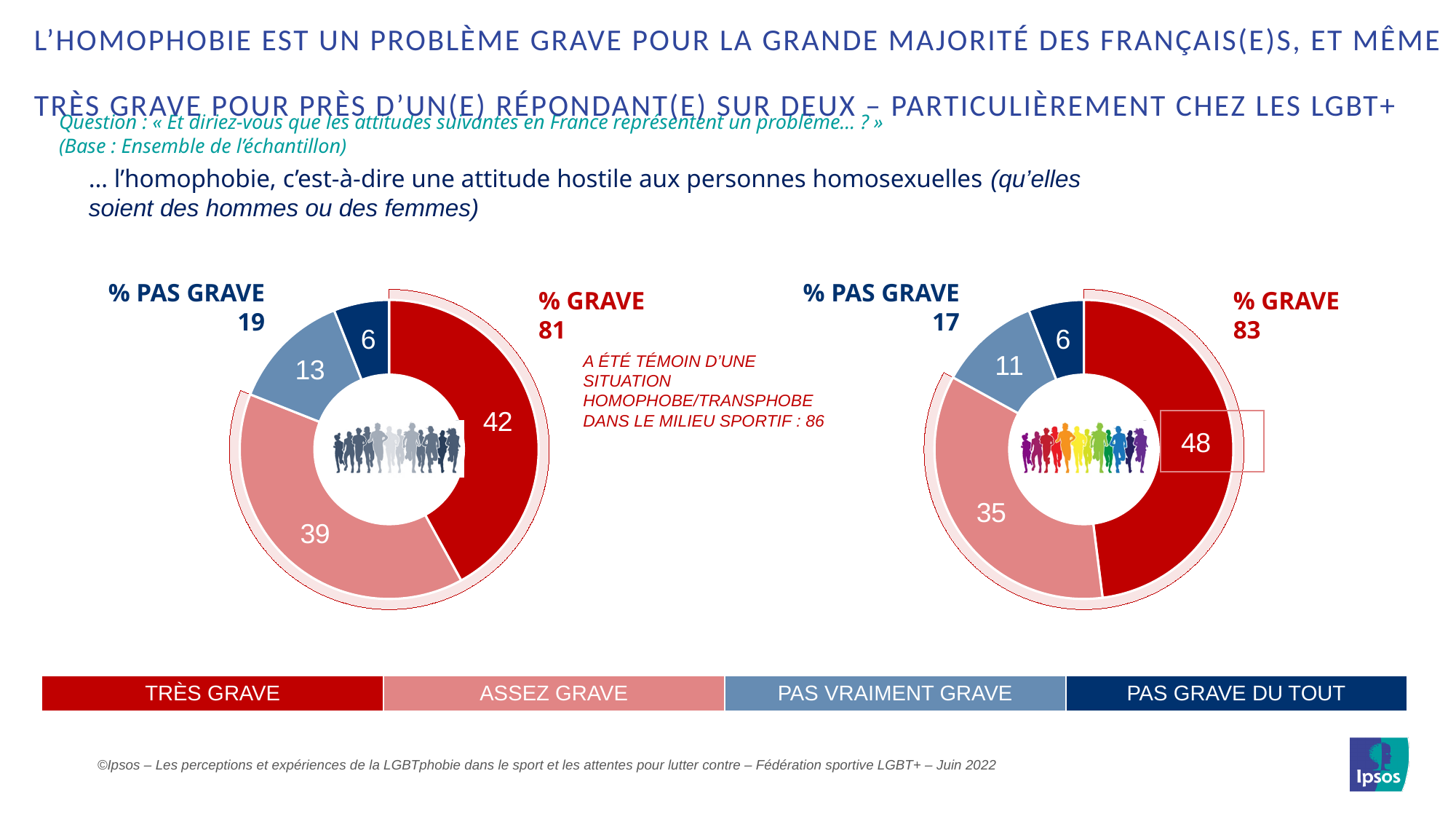
What type of chart is used on this slide? Donut (pie) chart In the left donut chart, what percentage of respondents answered "Très grave"? 42 What is the combined "% Grave" total shown for the right donut chart? 83 How many categories does the legend at the bottom of the slide list? 4 In the right donut chart, what is the value for "Pas vraiment grave"? 11 In the left donut chart, what is the value for "Assez grave"? 39 What is the "% Pas grave" total shown for the left donut chart? 19 Which chart has the larger "Assez grave" value, the left or the right donut chart? Left What is the difference between the "Très grave" values in the right and left donut charts? 6 In the right donut chart, what percentage of respondents answered "Très grave"? 48 In the left donut chart, which category has the smallest share? Pas grave du tout In the right donut chart, which category has the largest share? Très grave